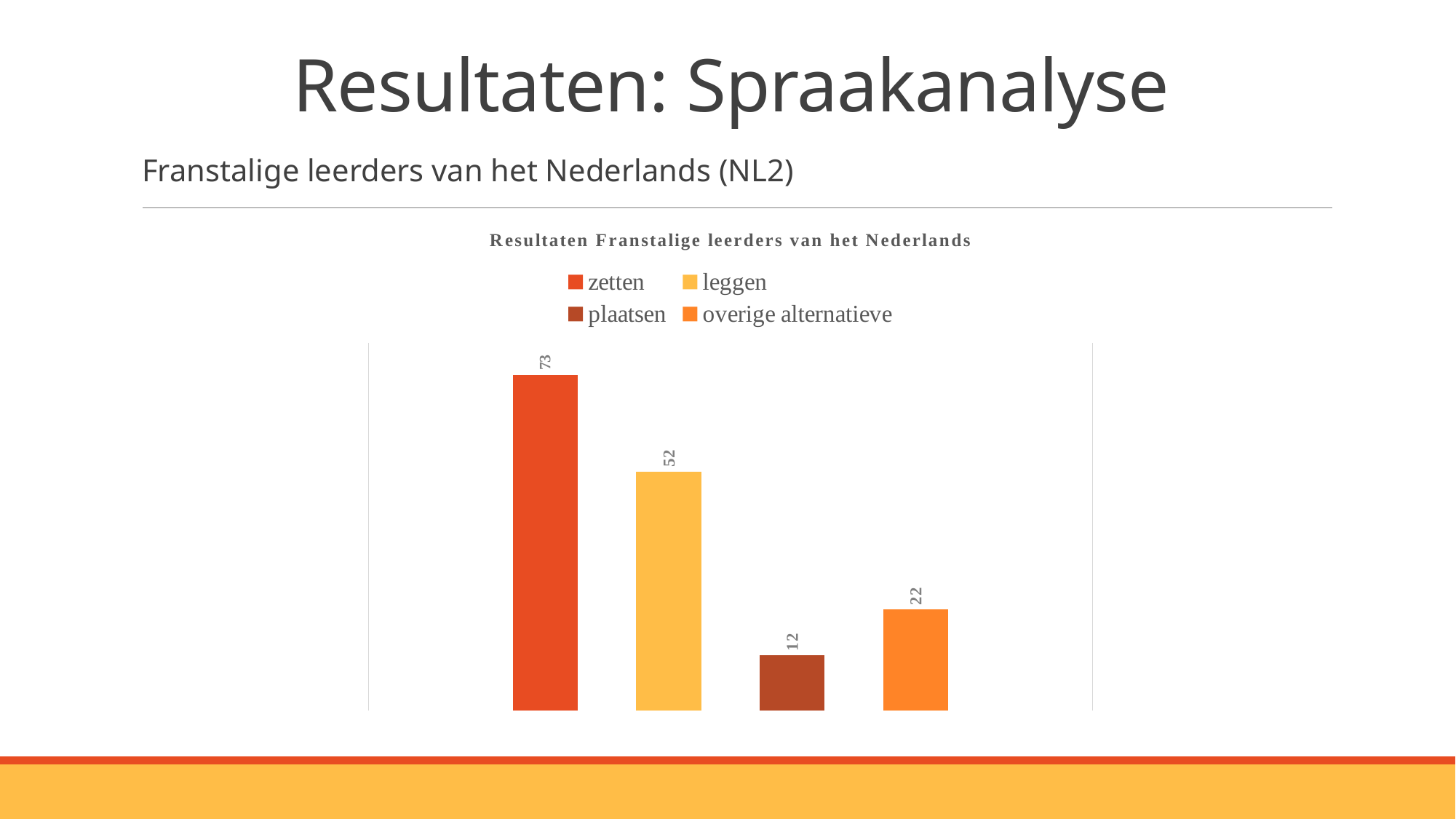
What kind of chart is shown on the slide? bar chart What is the difference between the values for overige alternatieve and plaatsen? 10 Which category has the highest value? zetten What is the value for overige alternatieve? 22 Which is larger, the value for leggen or the value for overige alternatieve? leggen What is the value for plaatsen? 12 What is the difference between the values for zetten and leggen? 21 What is the value for leggen? 52 Which category has the lowest value? plaatsen What is the title of the chart? Resultaten Franstalige leerders van het Nederlands How many bars are shown in the chart? 4 What is the value for zetten? 73